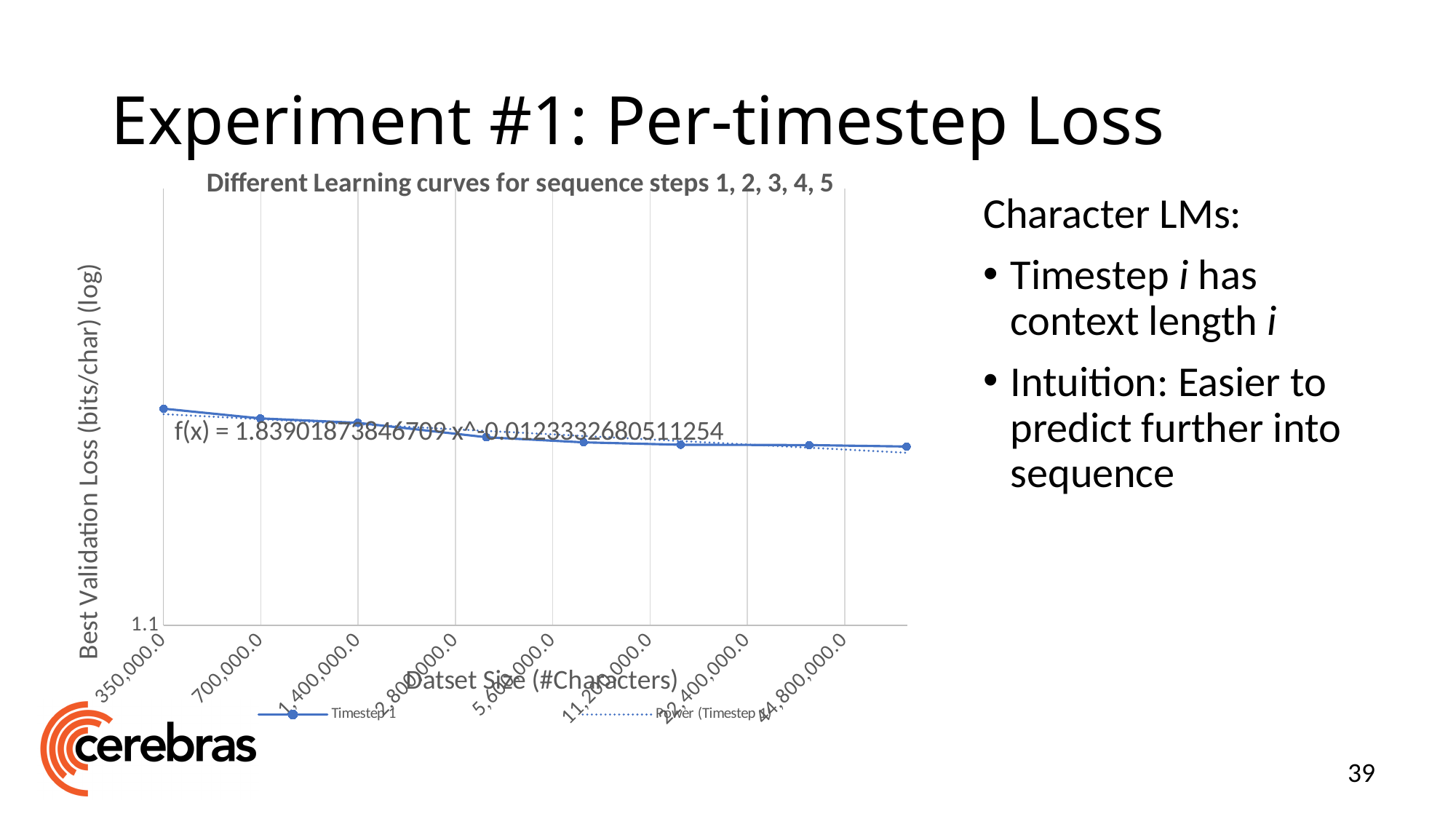
What type of chart is shown on the slide? line chart What is the label of the x axis? Datset Size (#Characters) Does the Timestep 1 series rise or fall as dataset size increases along the x axis? fall How many data points are plotted for the Timestep 1 series? 8 How many entries does the chart legend list? 2 Is the Timestep 1 value at 350,000.0 greater or less than 1.1? greater At which dataset size is the Timestep 1 validation loss highest? 350,000.0 What is the first entry in the chart legend? Timestep 1 What is the title of the chart? Different Learning curves for sequence steps 1, 2, 3, 4, 5